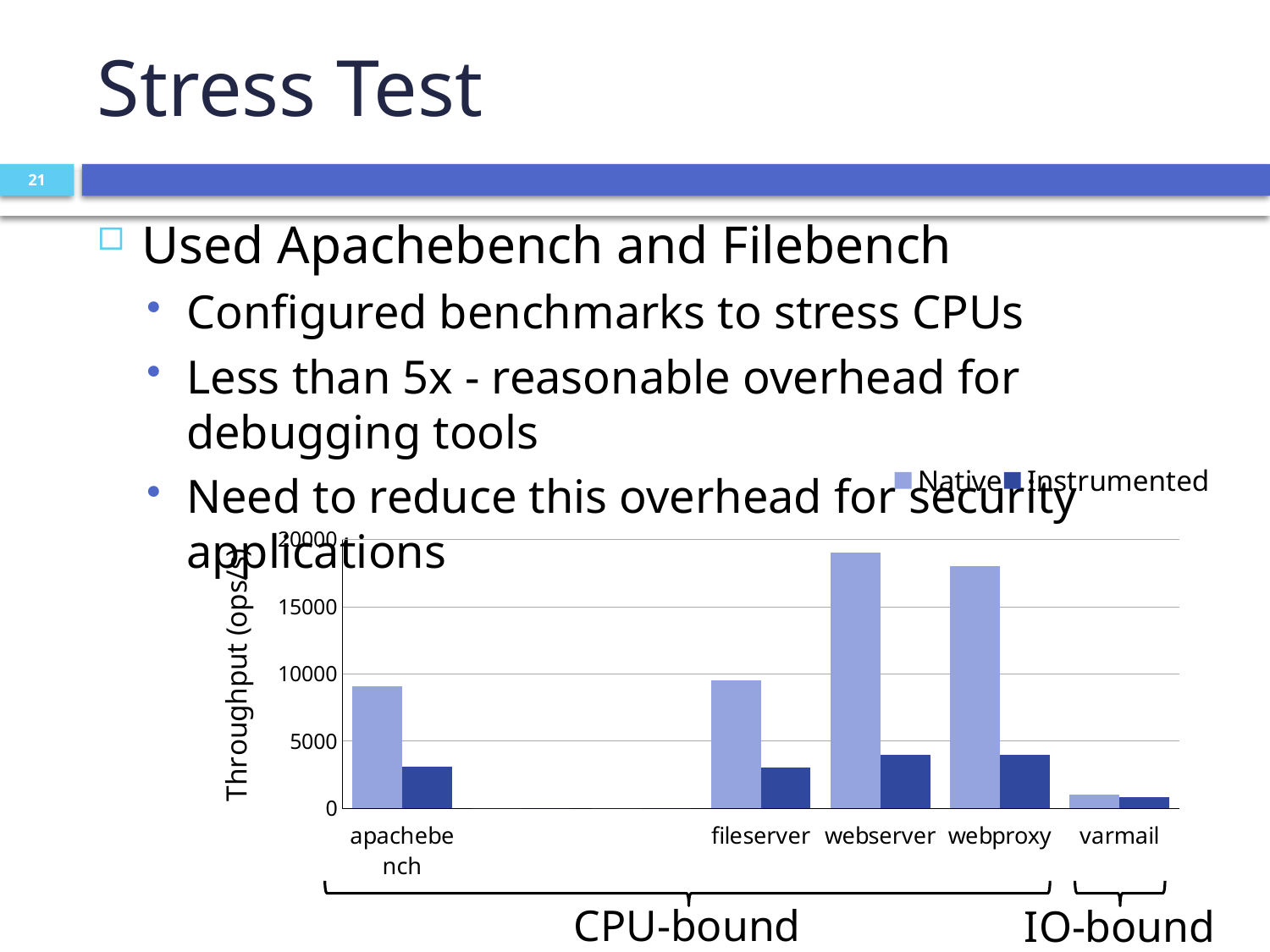
What kind of chart is shown on the slide? bar chart For webproxy, which is larger: the Native value or the Instrumented value? Native Which category has the highest Native throughput? webserver Is the Native value for varmail greater or less than 5000? less Is the Native value for apachebench greater or less than 10000? less Which benchmark is grouped as IO-bound? varmail Is the Instrumented value for fileserver greater or less than 5000? less Which category has the lowest Native throughput? varmail What is the label of the y axis? Throughput (ops/s) How many benchmark categories are shown on the x axis? 5 How many series does the legend list? 2